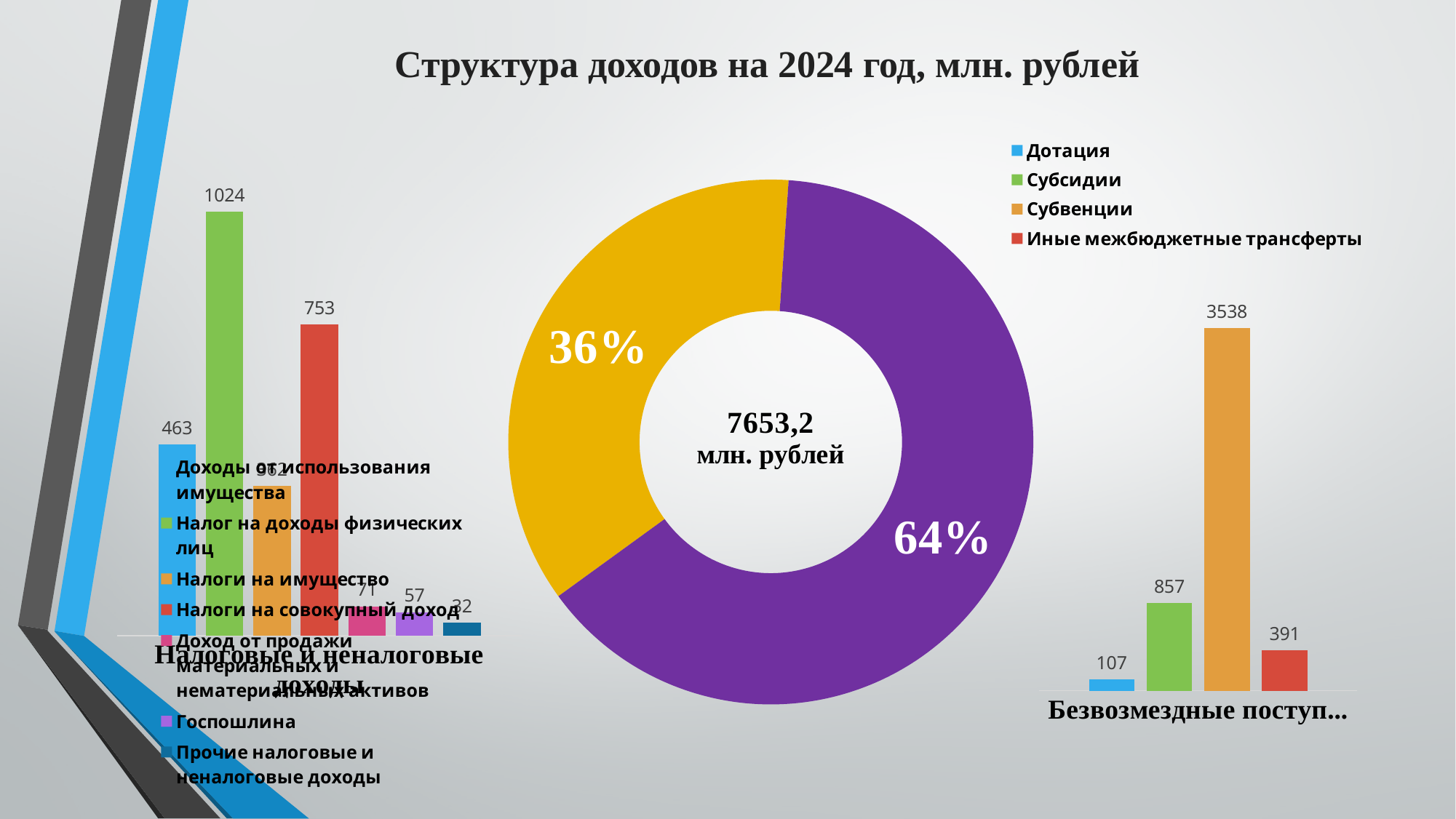
In the bar chart titled 'Налоговые и неналоговые доходы', what is the value for Налог на доходы физических лиц? 1024 In the bar chart titled 'Налоговые и неналоговые доходы', which is larger: Доходы от использования имущества or Госпошлина? Доходы от использования имущества In the bar chart titled 'Безвозмездные поступ...', which category has the highest value? Субвенции In the bar chart titled 'Безвозмездные поступ...', what is the value for Дотация? 107 In the bar chart titled 'Безвозмездные поступ...', what is the difference between Субсидии and Иные межбюджетные трансферты? 466 In the bar chart titled 'Налоговые и неналоговые доходы', what is the difference between Налог на доходы физических лиц and Доходы от использования имущества? 561 In the bar chart titled 'Безвозмездные поступ...', what is the value for Субвенции? 3538 What total value is shown in the centre of the donut chart? 7653,2 млн. рублей In the donut chart in the centre of the slide, what share does the purple slice represent? 64% In the bar chart titled 'Безвозмездные поступ...', which category has the lowest value? Дотация In the bar chart titled 'Налоговые и неналоговые доходы', what is the value for Налоги на совокупный доход? 753 How many categories does the legend of the bar chart titled 'Налоговые и неналоговые доходы' list? 7